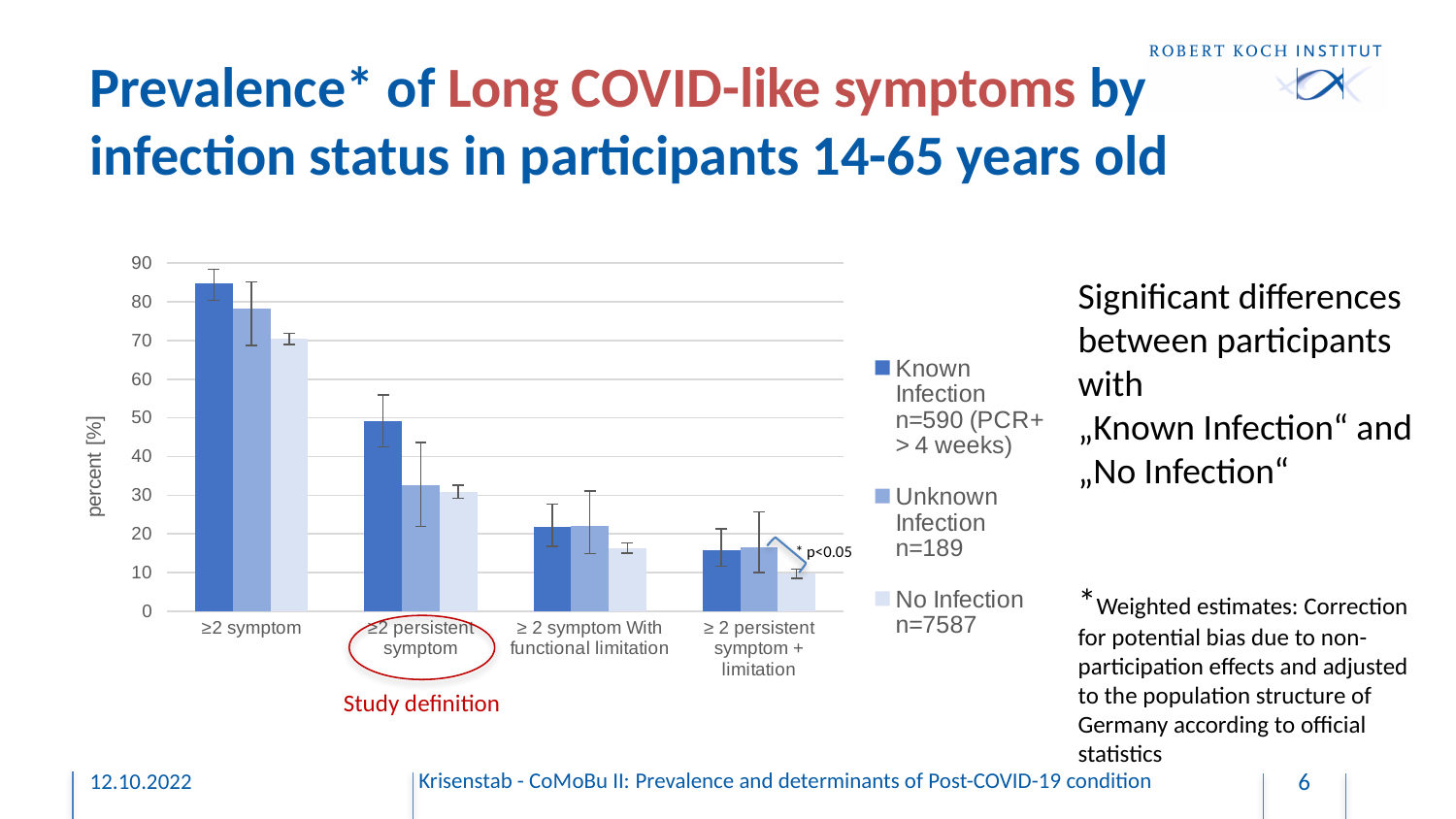
What is the label of the chart's y axis? percent [%] For the Known Infection series, which category has the highest value? ≥2 symptom For the No Infection series, which category has the lowest value? ≥ 2 persistent symptom + limitation In the "≥2 symptom" category, which is larger: the value for Known Infection or for No Infection? Known Infection Is the value for No Infection in the "≥2 symptom" category greater or less than 60? greater Do the Known Infection values rise or fall from left to right across the categories? fall Is the value for Known Infection in the "≥2 symptom" category greater or less than 80? greater Is the value for No Infection in the "≥2 persistent symptom" category greater or less than 40? less How many series does the chart's legend list? 3 How many symptom categories are shown on the x axis of the chart? 4 What kind of chart is shown on the slide? bar chart